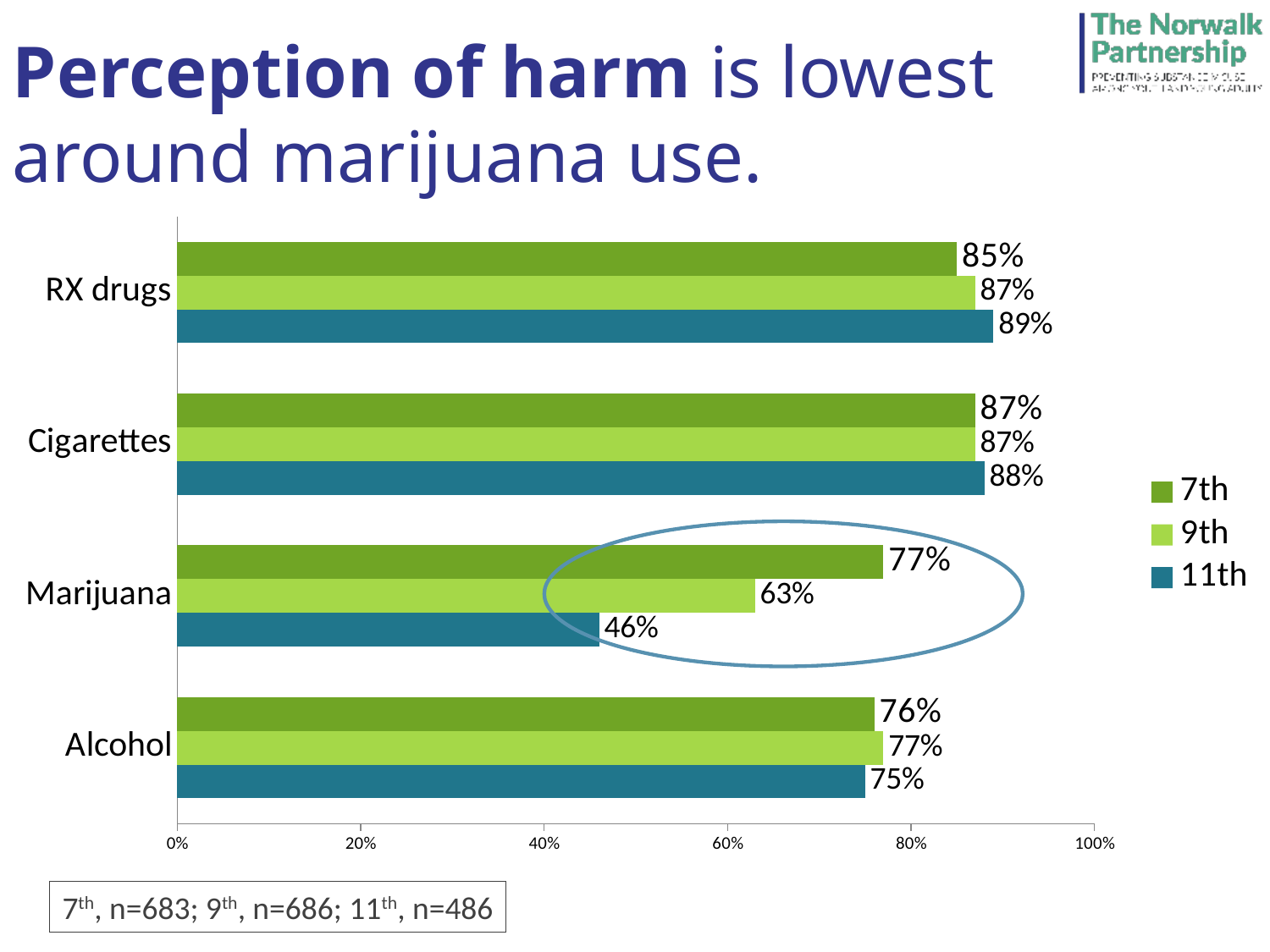
Is the 9th grade value for Marijuana greater or less than 60%? greater What kind of chart is shown on the slide? Bar chart How many series does the legend list? 3 Which is larger for Cigarettes: the 7th grade value or the 11th grade value? 11th grade Which series is shown in dark teal in the legend? 11th Which category has the lowest value for 11th grade? Marijuana How many categories are shown on the chart? 4 What is the value for 11th grade for Marijuana? 46% What is the value for 7th grade for RX drugs? 85% What is the value for 9th grade for Alcohol? 77% Which category has the highest value for 11th grade? RX drugs What is the difference between the 7th grade and 11th grade values for Marijuana? 31%